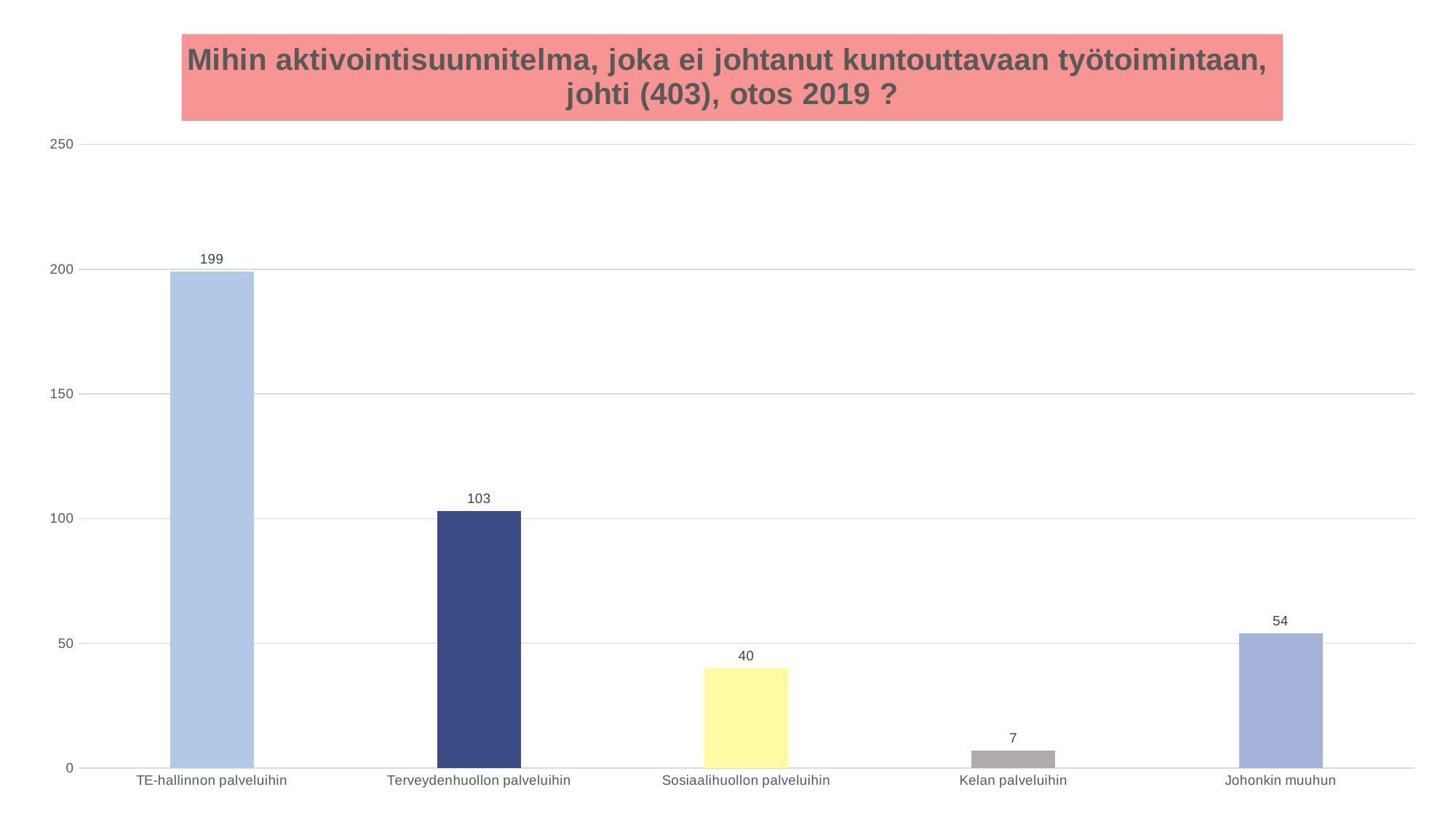
Which is larger, the value for Sosiaalihuollon palveluihin or Johonkin muuhun? Johonkin muuhun How many categories are shown on the x axis? 5 What is the value for TE-hallinnon palveluihin? 199 What is the difference between the values for TE-hallinnon palveluihin and Terveydenhuollon palveluihin? 96 Which category has the highest value? TE-hallinnon palveluihin What is the difference between the values for Johonkin muuhun and Kelan palveluihin? 47 What is the value for Kelan palveluihin? 7 Is the value for Sosiaalihuollon palveluihin greater or less than 50? less What kind of chart is shown on the slide? bar chart What is the value for Terveydenhuollon palveluihin? 103 Which category has the lowest value? Kelan palveluihin What is the value for Johonkin muuhun? 54